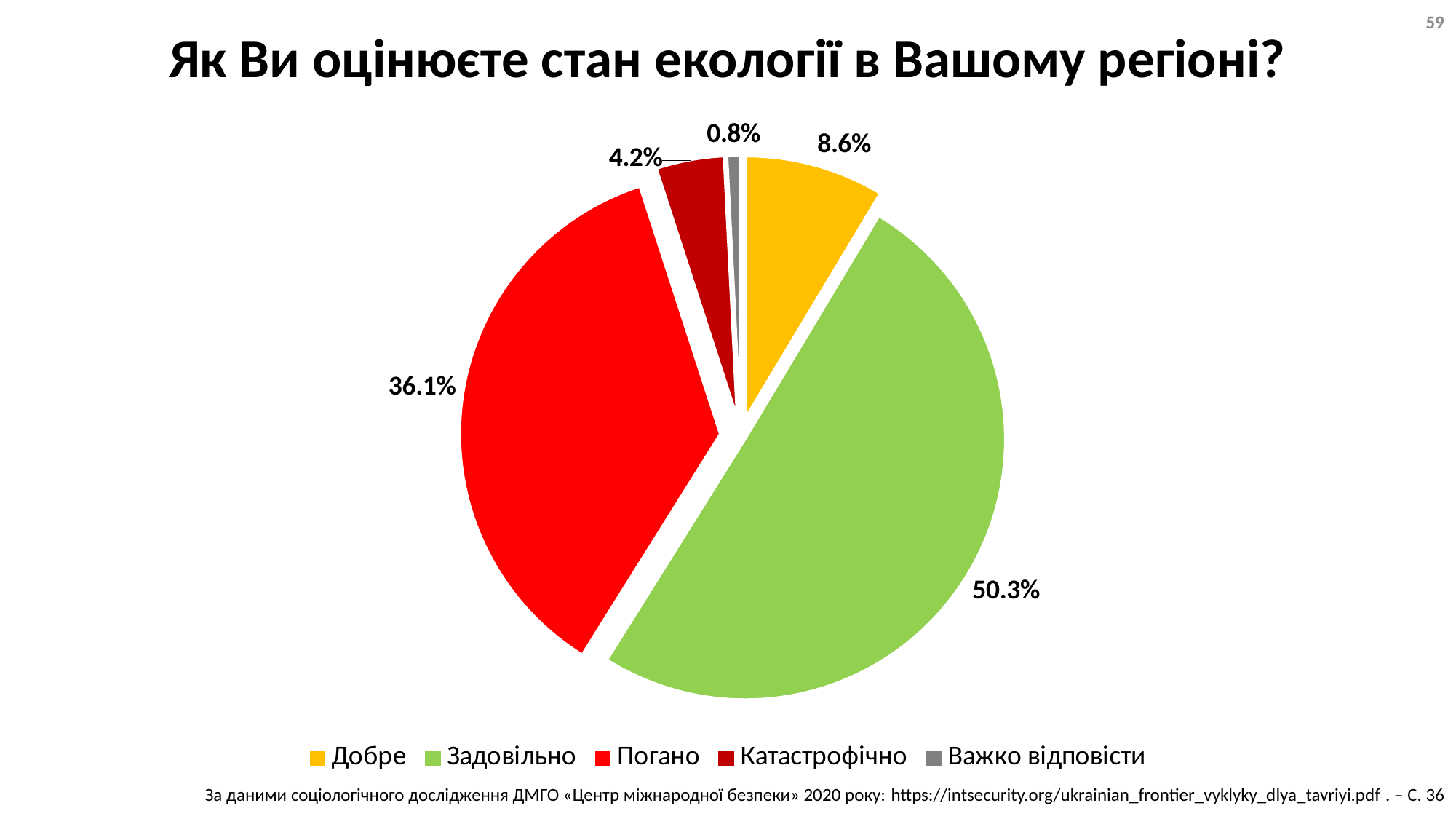
What colour is the slice for Погано? Red Which is larger, Добре or Катастрофічно? Добре What is the value for Катастрофічно? 4.2% What is the value for Добре? 8.6% What share of the pie does Задовільно take? 50.3% What is the value for Погано? 36.1% Which category has the largest slice? Задовільно What kind of chart is shown on the slide? Pie chart What is the difference between the values for Задовільно and Погано? 14.2% How many categories does the pie chart show? 5 What is the value for Важко відповісти? 0.8% Which category has the smallest slice? Важко відповісти